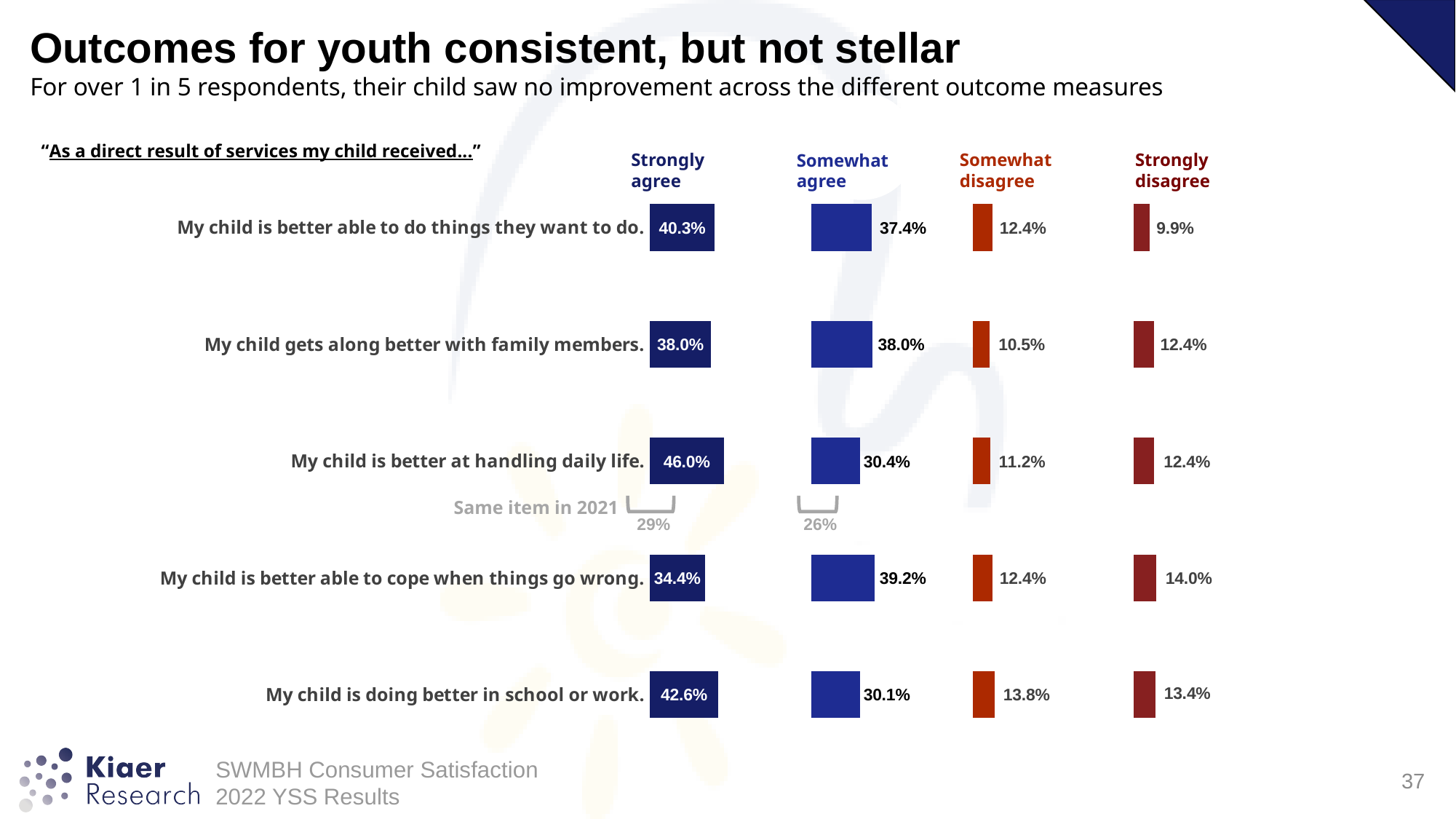
Which item has a larger Somewhat disagree value: "My child is doing better in school or work" or "My child gets along better with family members"? My child is doing better in school or work. What kind of chart is shown on the slide? Bar chart What was the Strongly agree value for the same "handling daily life" item in 2021? 29% What percentage strongly agree that "My child is better at handling daily life"? 46.0% What percentage strongly disagree that "My child is better able to do things they want to do"? 9.9% Which item has the highest Strongly disagree percentage? My child is better able to cope when things go wrong. How many outcome items are shown in the chart? 5 What is the Somewhat agree value for "My child gets along better with family members"? 38.0% For "My child is better at handling daily life", how many percentage points higher is Strongly agree than Somewhat agree? 15.6 percentage points Which item has the lowest Strongly agree percentage? My child is better able to cope when things go wrong. How many response categories (series) does the chart show? 4 Which item has the highest Strongly agree percentage? My child is better at handling daily life.